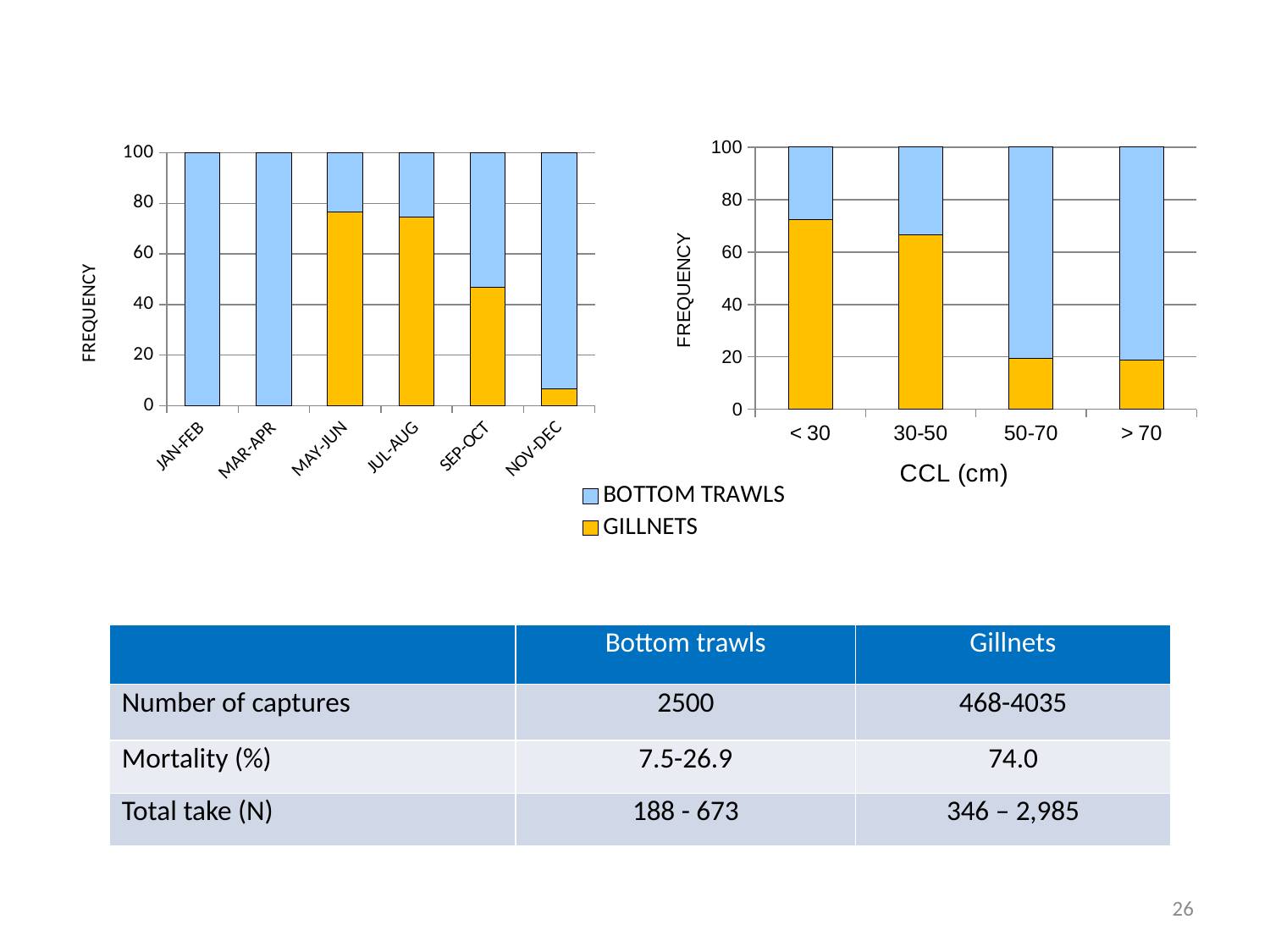
In the left chart (months), is the GILLNETS value for MAY-JUN greater or less than 60? greater How many categories are shown on the x axis of the right chart (CCL (cm))? 4 In the right chart (CCL (cm)), is the GILLNETS value for < 30 greater or less than 60? greater In the right chart (CCL (cm)), which is larger, the GILLNETS value for 30-50 or for 50-70? 30-50 What kind of chart is the left chart (months on the x axis)? stacked bar chart How many series does the legend list? 2 In the left chart (months), which category has the lowest BOTTOM TRAWLS share among MAY-JUN, SEP-OCT and NOV-DEC? MAY-JUN In the left chart (months), does the GILLNETS share rise or fall from MAY-JUN to NOV-DEC? fall In the left chart (months), is the GILLNETS value for NOV-DEC greater or less than 20? less What is the x-axis title of the right chart? CCL (cm) How many categories are shown on the x axis of the left chart (months)? 6